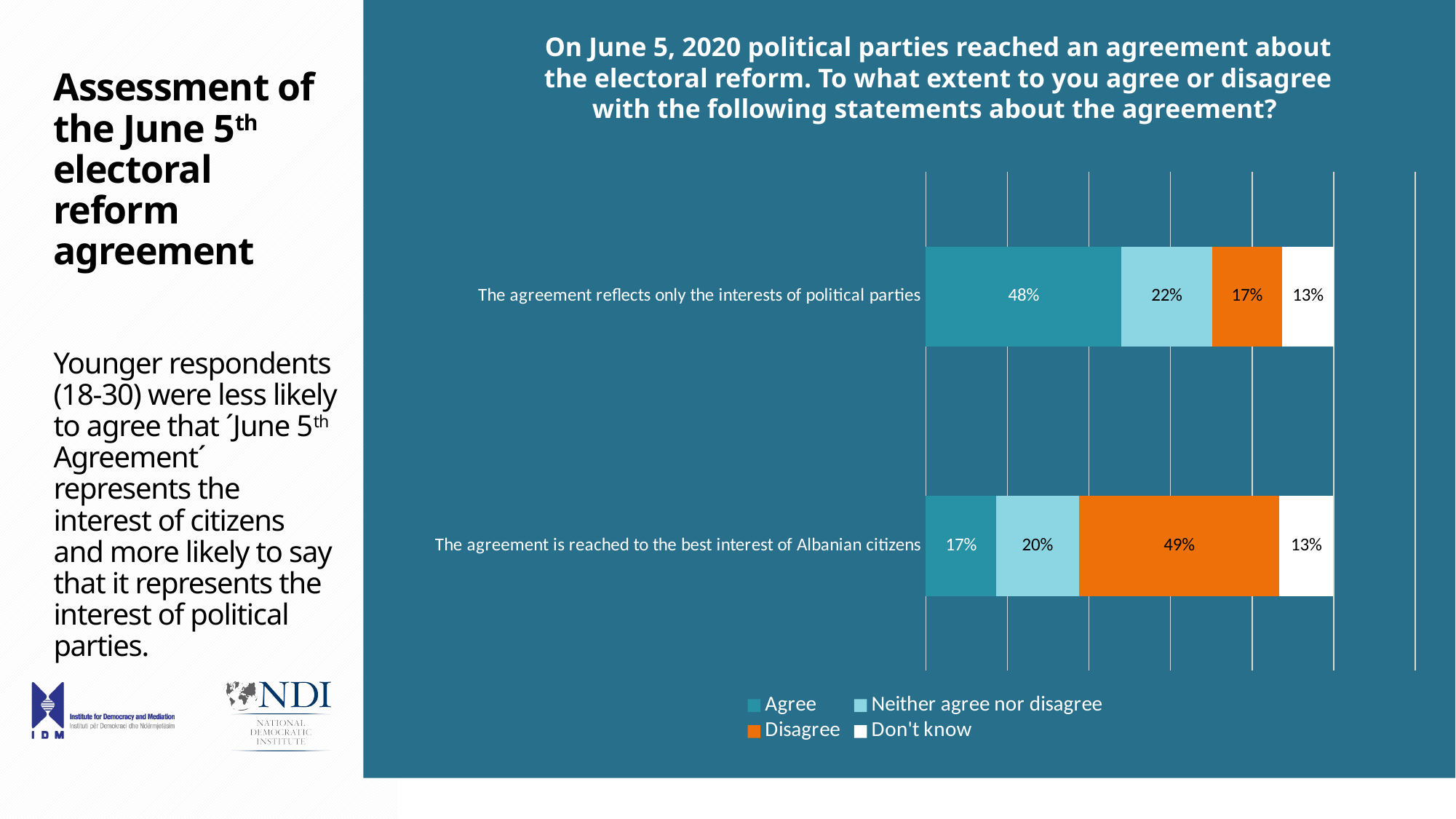
What type of chart is shown on the slide? Stacked bar chart Which colour represents 'Disagree' in the chart? Orange What percentage of respondents agree that the agreement reflects only the interests of political parties? 48% What percentage of respondents disagree that the agreement is reached to the best interest of Albanian citizens? 49% How many series does the legend list? 4 What is the 'Don't know' value for the statement 'The agreement is reached to the best interest of Albanian citizens'? 13% What is the 'Neither agree nor disagree' value for the statement 'The agreement reflects only the interests of political parties'? 22% Which statement has the lower 'Disagree' share? The agreement reflects only the interests of political parties How many statements (bars) are shown in the chart? 2 Is the 'Disagree' value larger for 'The agreement reflects only the interests of political parties' or for 'The agreement is reached to the best interest of Albanian citizens'? The agreement is reached to the best interest of Albanian citizens Which statement has the higher 'Agree' share? The agreement reflects only the interests of political parties What is the difference between the 'Agree' values for the two statements? 31 percentage points